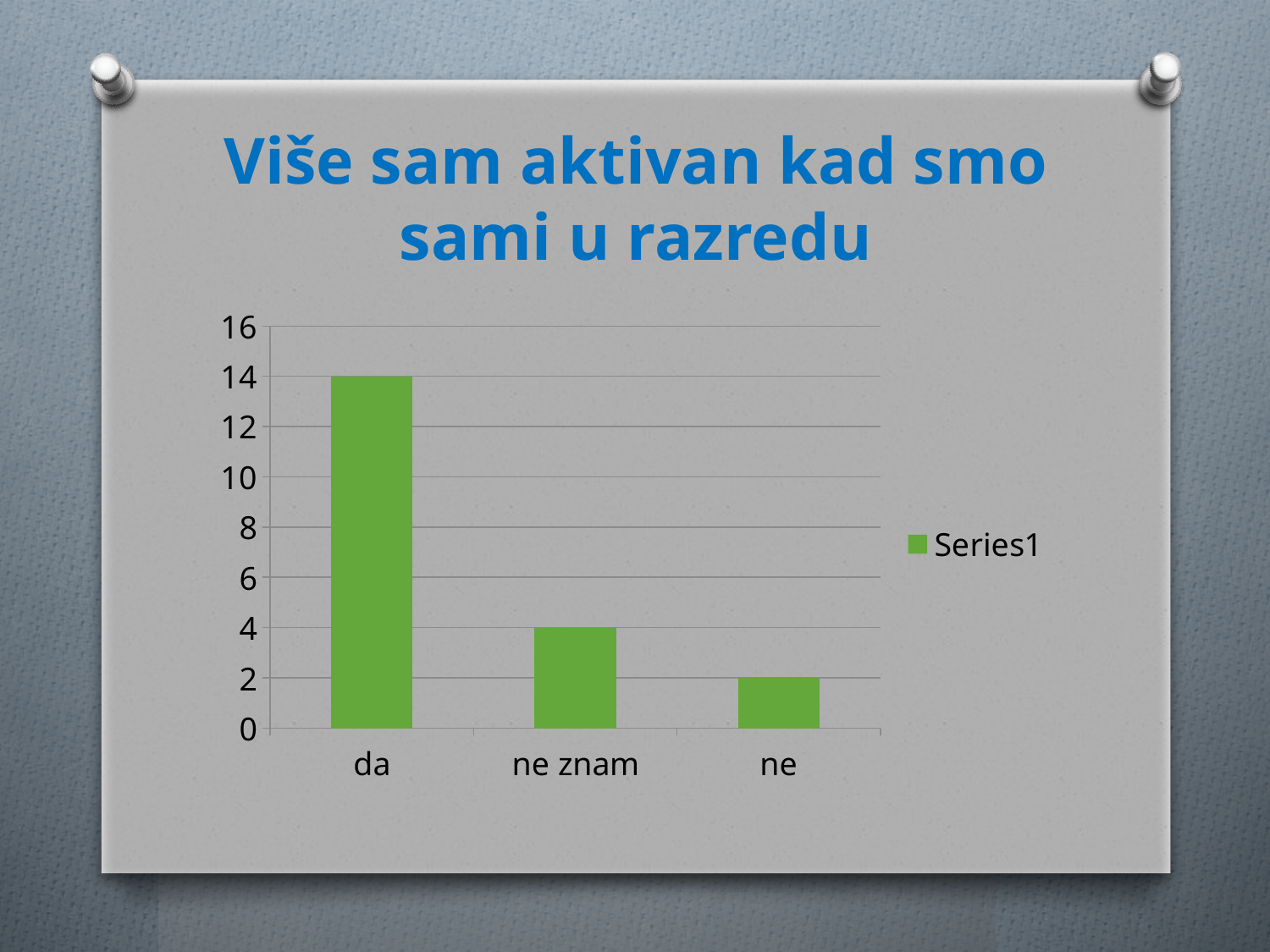
Is the value for "da" greater or less than 10? greater What is the value for "ne"? 2 What kind of chart is shown on the slide? bar chart How many series does the legend list? 1 What is the difference between the values for "da" and "ne znam"? 10 What is the value for "da"? 14 What is the value for "ne znam"? 4 Which is larger, the value for "ne znam" or the value for "ne"? ne znam Which category has the lowest value? ne How many categories are shown on the x axis? 3 What is the difference between the values for "ne znam" and "ne"? 2 Which category has the highest value? da